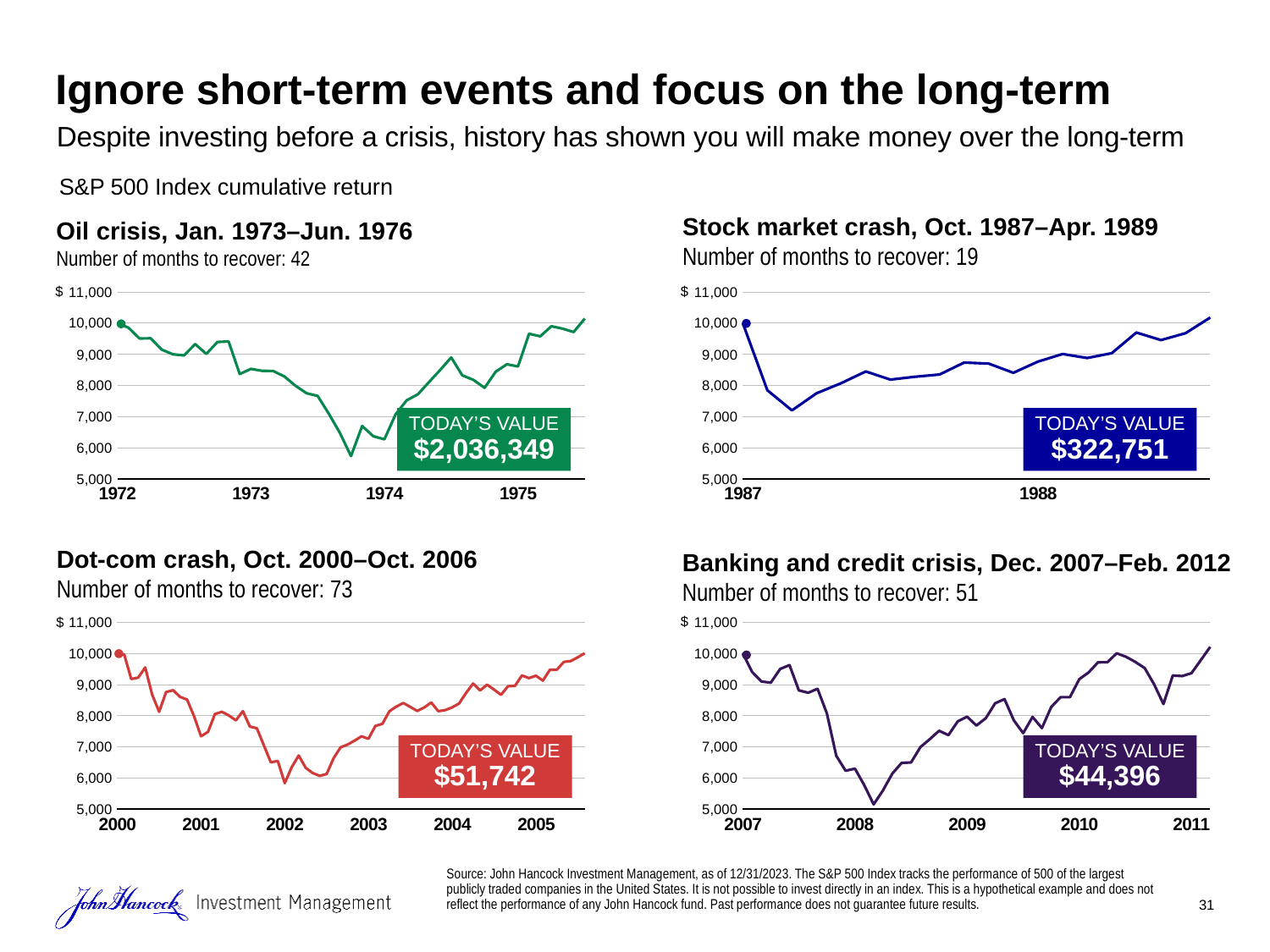
On the 'Oil crisis, Jan. 1973–Jun. 1976' chart, what is today's value shown in the box? $2,036,349 On the 'Oil crisis, Jan. 1973–Jun. 1976' chart, is the lowest point of the line greater or less than 6,000? less On the 'Stock market crash, Oct. 1987–Apr. 1989' chart, what is today's value shown in the box? $322,751 On the 'Banking and credit crisis, Dec. 2007–Feb. 2012' chart, is the lowest point of the line greater or less than 6,000? less On the 'Stock market crash, Oct. 1987–Apr. 1989' chart, is the lowest point of the line greater or less than 7,000? greater What kind of chart is the 'Oil crisis, Jan. 1973–Jun. 1976' chart? Line chart How many charts are shown on the slide? 4 Which of the four crises shown has the largest number of months to recover? Dot-com crash, Oct. 2000–Oct. 2006 On the 'Oil crisis, Jan. 1973–Jun. 1976' chart, what value does the line start at in 1972? $10,000 What is the difference in number of months to recover between the Dot-com crash and the Stock market crash? 54 On the 'Dot-com crash, Oct. 2000–Oct. 2006' chart, what is today's value shown in the box? $51,742 On the 'Banking and credit crisis, Dec. 2007–Feb. 2012' chart, what is today's value shown in the box? $44,396